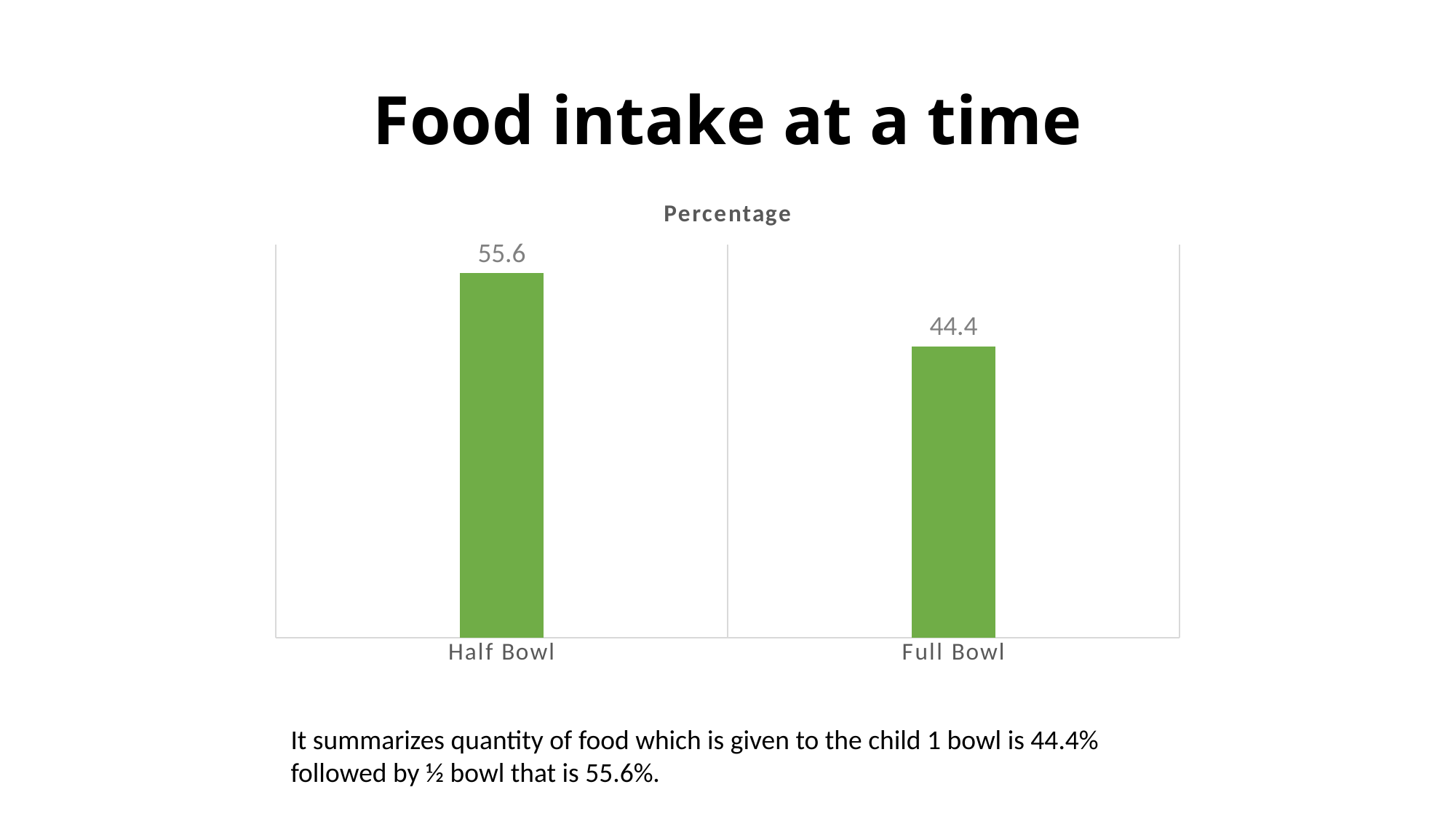
How many categories are shown in the chart? 2 What is the value for Full Bowl? 44.4 What is the total of the two values shown in the chart? 100 Do the values rise or fall from Half Bowl to Full Bowl? Fall What is the title of the chart? Percentage Which category has the lowest value? Full Bowl What kind of chart is shown on the slide? Bar chart Which category has the highest value? Half Bowl Which is larger, the value for Half Bowl or the value for Full Bowl? Half Bowl What is the difference between the values for Half Bowl and Full Bowl? 11.2 What is the value for Half Bowl? 55.6 What colour are the bars in the chart? Green